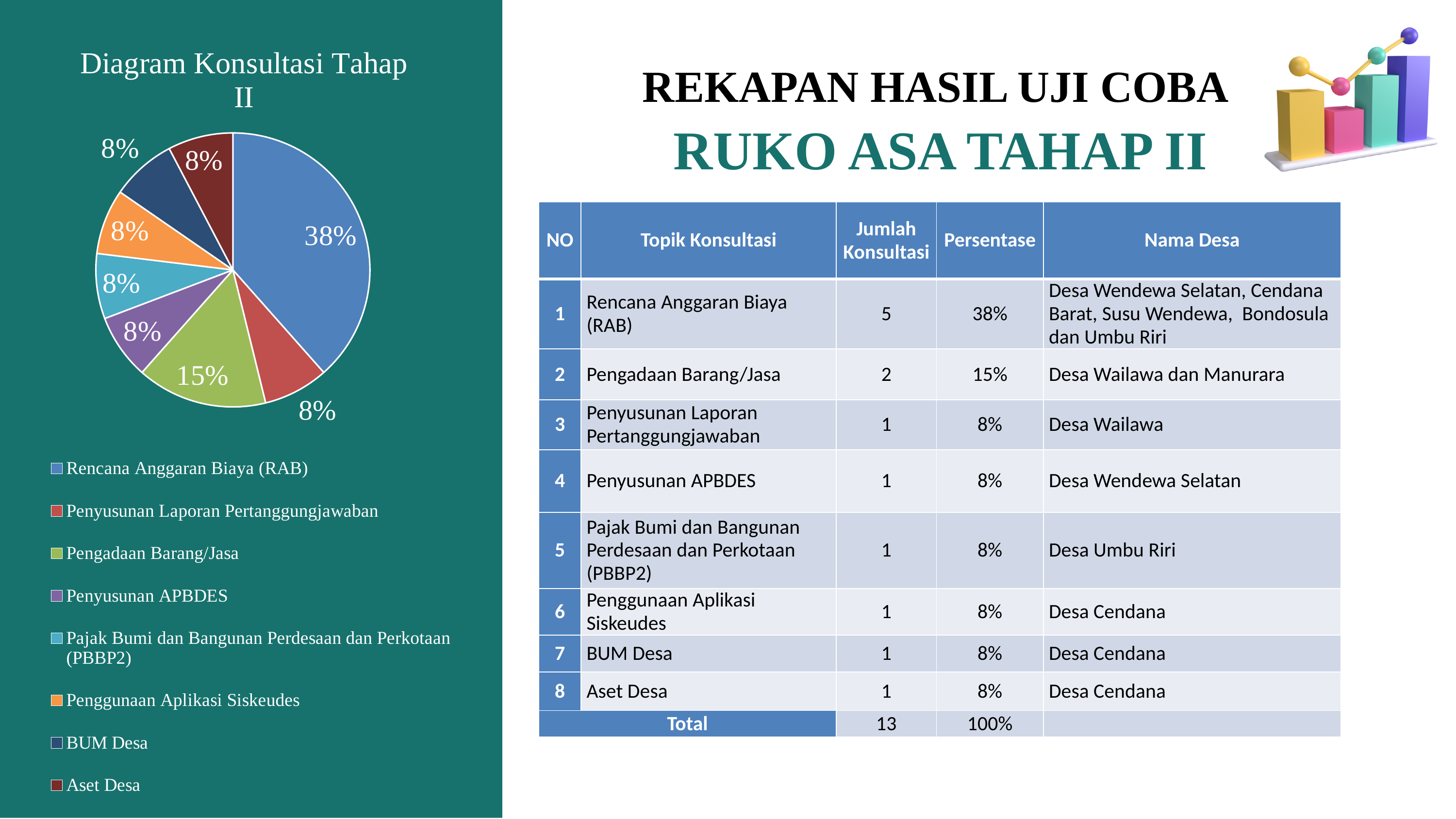
What share of the pie does Penyusunan APBDES have? 8% Which legend entry is shown in green? Pengadaan Barang/Jasa What share of the pie does Rencana Anggaran Biaya (RAB) have? 38% Which category has the largest slice of the pie? Rencana Anggaran Biaya (RAB) What is the difference in percentage points between the Rencana Anggaran Biaya (RAB) slice and the Pengadaan Barang/Jasa slice? 23 percentage points What kind of chart is shown on the slide? Pie chart Which is larger, the slice for Pengadaan Barang/Jasa or the slice for Aset Desa? Pengadaan Barang/Jasa What is the title of the chart? Diagram Konsultasi Tahap II What share of the pie does Pengadaan Barang/Jasa have? 15% How many slices does the pie chart have? 8 What is the difference in percentage points between the Pengadaan Barang/Jasa slice and the Penggunaan Aplikasi Siskeudes slice? 7 percentage points